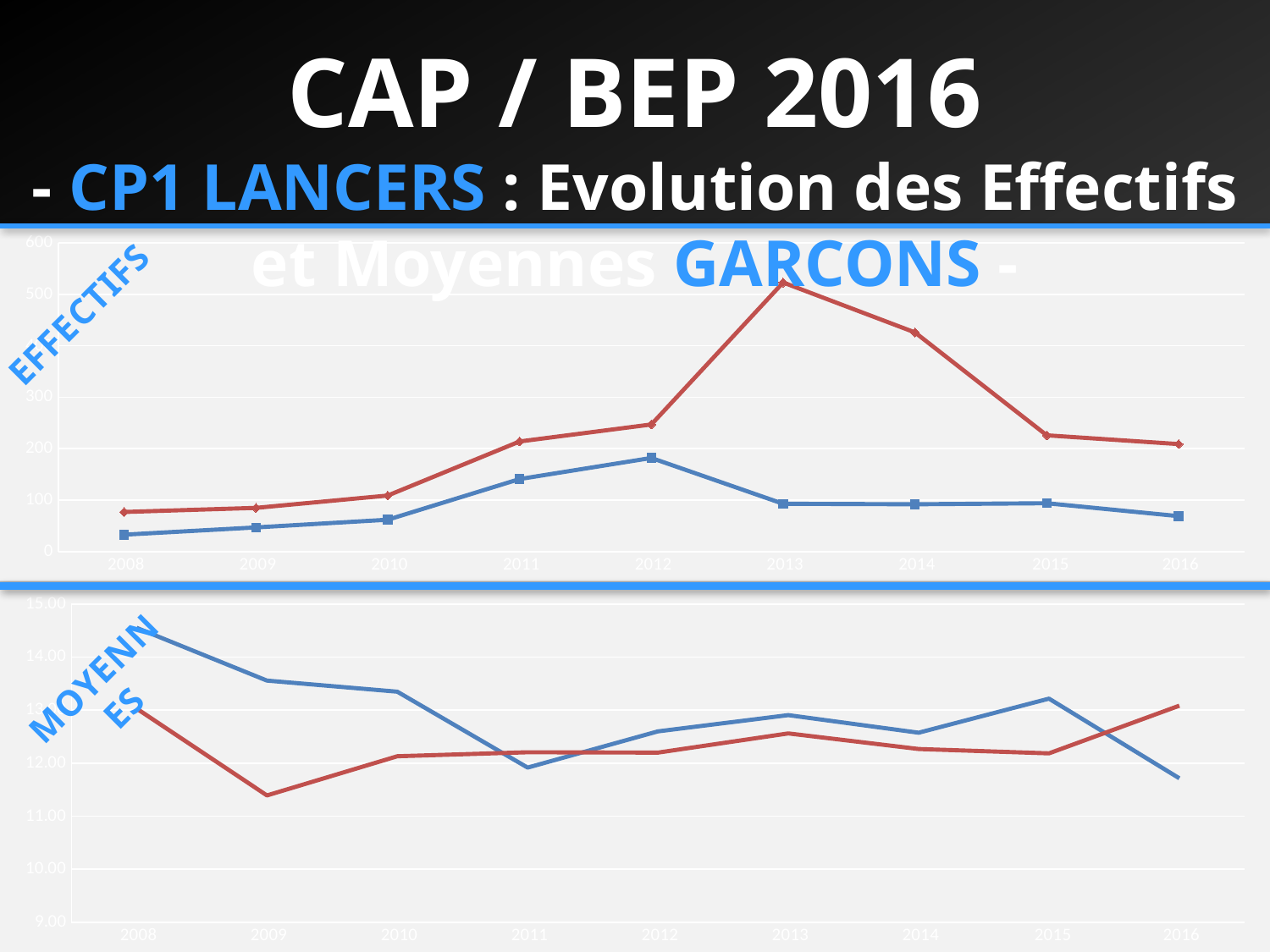
In the bottom chart (MOYENNES), is the value of the blue line in 2008 greater or less than 14.00? greater How many years are shown on the x axis of the top chart (EFFECTIFS)? 9 In the top chart (EFFECTIFS), in which year does the blue line reach its highest value? 2012 In the bottom chart (MOYENNES), does the blue line rise or fall from 2008 to 2011? fall In the bottom chart (MOYENNES), which line has the higher value in 2008, the blue line or the red line? blue line In the top chart (EFFECTIFS), does the red line rise or fall from 2013 to 2016? fall In the top chart (EFFECTIFS), in which year does the red line reach its highest value? 2013 In the bottom chart (MOYENNES), in which year is the red line at its lowest? 2009 In the top chart (EFFECTIFS), in which year is the blue line at its lowest? 2008 What kind of chart is the top chart (EFFECTIFS)? line chart In the top chart (EFFECTIFS), is the value of the red line in 2013 greater or less than 400? greater In the top chart (EFFECTIFS), is the value of the blue line in 2008 greater or less than 100? less